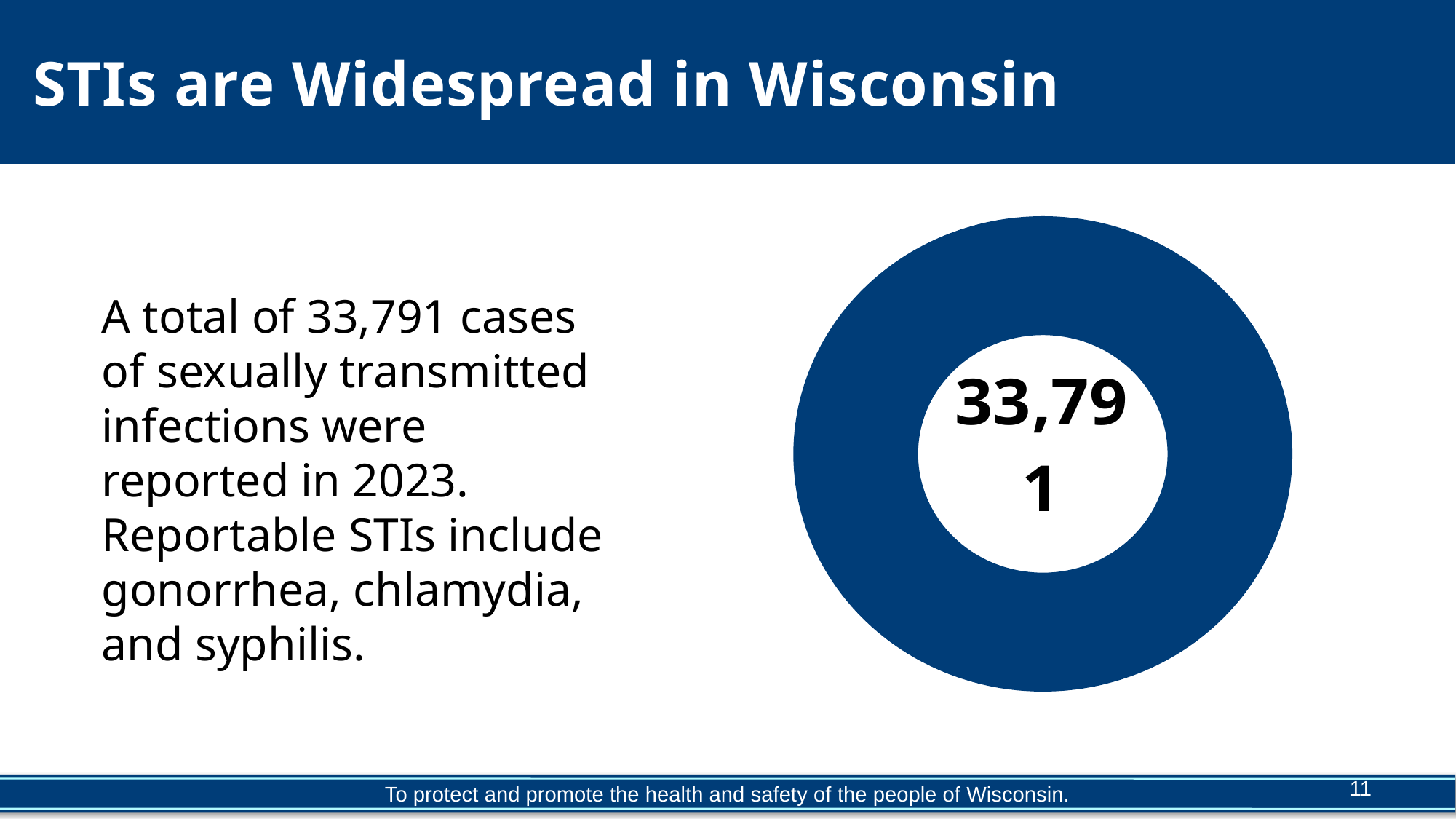
What colour is the ring of the doughnut chart? dark blue Does the doughnut chart display a legend? No Is the value shown in the center of the doughnut chart greater or less than 30,000? greater How many segments does the doughnut chart ring contain? 1 What number is printed in the center of the doughnut chart? 33,791 What share of the doughnut chart ring does the single segment occupy? 100% What kind of chart is shown on the right side of the slide? doughnut chart